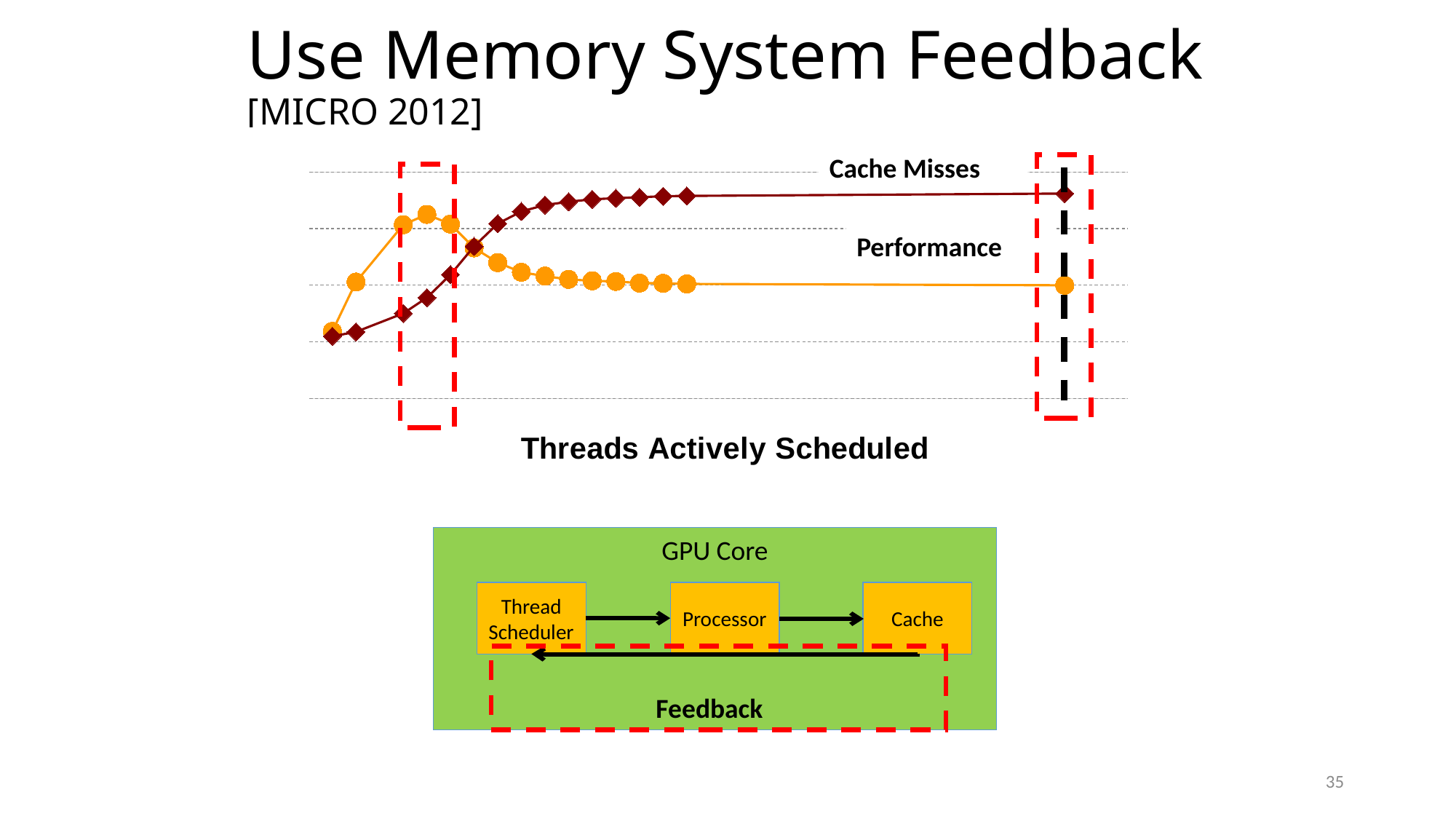
What are the names of the two series plotted in the chart? Cache Misses and Performance Which series reaches its peak at a smaller number of Threads Actively Scheduled, Cache Misses or Performance? Performance At the rightmost point of the chart, which series has the higher value, Cache Misses or Performance? Cache Misses After its peak, does the Performance series rise or fall as Threads Actively Scheduled increases? falls Does the Cache Misses series level off or keep rising at high numbers of Threads Actively Scheduled? levels off What kind of chart is shown on the slide? line chart Does the Cache Misses series rise or fall as Threads Actively Scheduled increases? rises What is the label of the x axis of the chart? Threads Actively Scheduled How many data series are plotted in the chart? 2